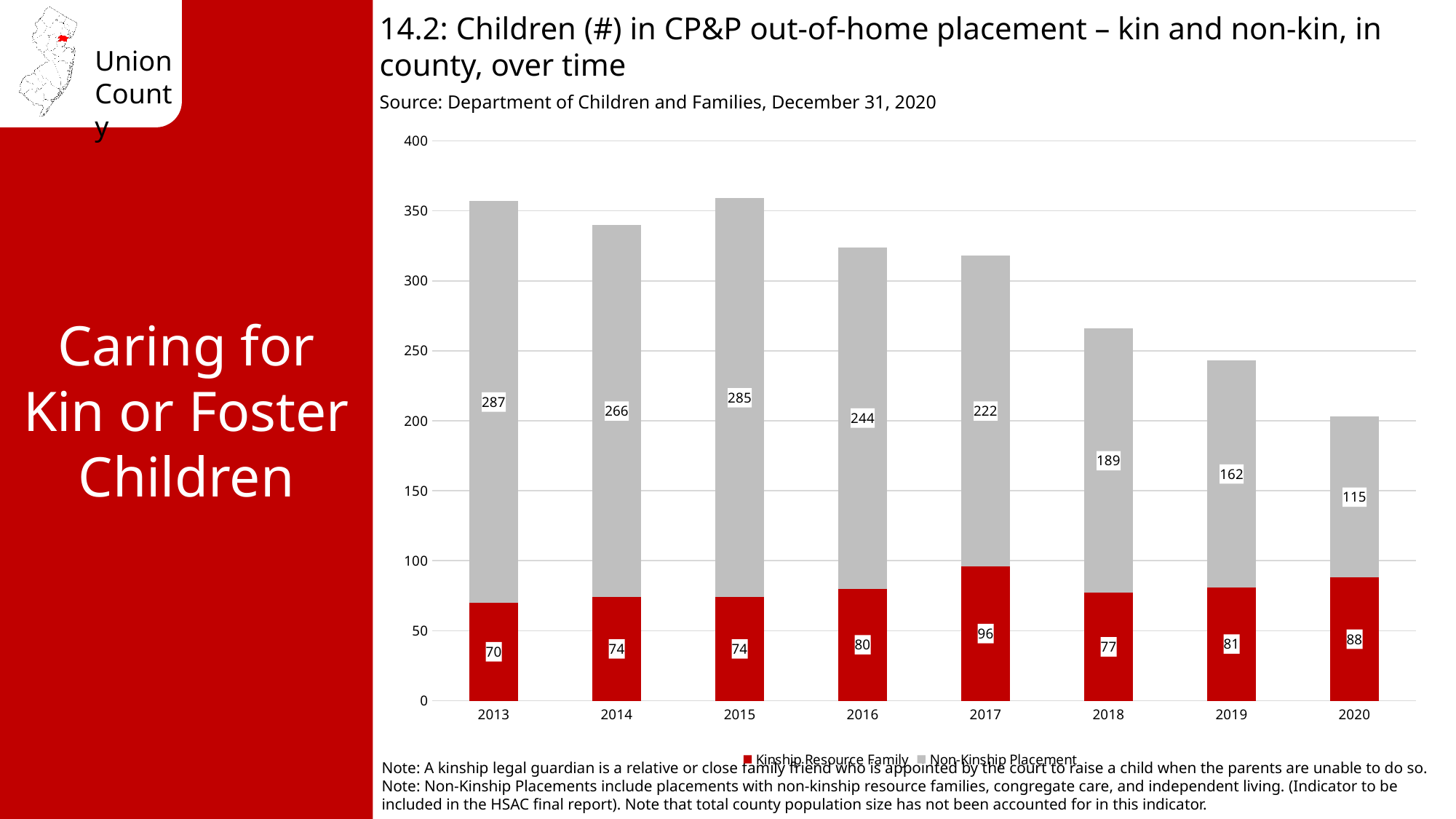
How many series does the legend list? 2 What is the difference between the Non-Kinship Placement values for 2013 and 2020? 172 What is the total of the stacked bar for 2020? 203 What is the Non-Kinship Placement value for 2020? 115 What is the total of the stacked bar for 2018? 266 What is the Kinship Resource Family value for 2017? 96 Which is larger, the Kinship Resource Family value for 2019 or for 2018? 2019 Which year has the lowest Kinship Resource Family value? 2013 How many years are shown on the x axis? 8 Does the Non-Kinship Placement value rise or fall from 2015 to 2020? Fall Which year has the highest Non-Kinship Placement value? 2013 What kind of chart is shown on the slide? Stacked bar chart